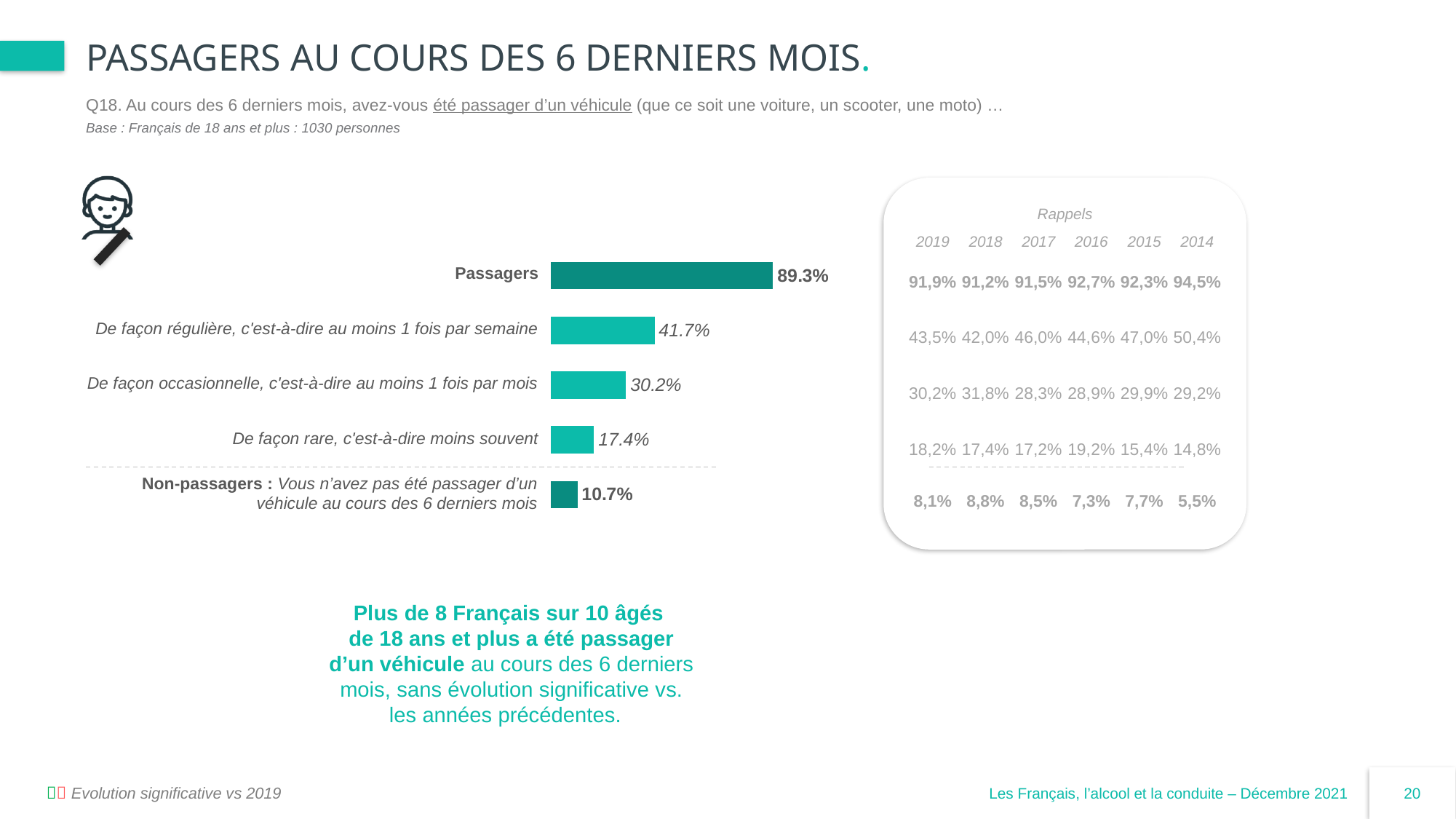
What is the value for "De façon rare, c'est-à-dire moins souvent"? 17.4% What is the difference between the values for "Passagers" and "Non-passagers"? 78.6% How many bars are shown in the bar chart? 5 What is the value for "De façon occasionnelle, c'est-à-dire au moins 1 fois par mois"? 30.2% Which category has the lowest value in the bar chart? Non-passagers Which is larger: the value for "De façon rare" or the value for "Non-passagers"? De façon rare What type of chart is shown on the slide? Bar chart Which category has the highest value in the bar chart? Passagers What is the value shown for "Passagers" in the bar chart? 89.3% What is the value for "De façon régulière, c'est-à-dire au moins 1 fois par semaine"? 41.7% What is the difference between the values for "De façon régulière" and "De façon occasionnelle"? 11.5% What is the value shown for "Non-passagers"? 10.7%